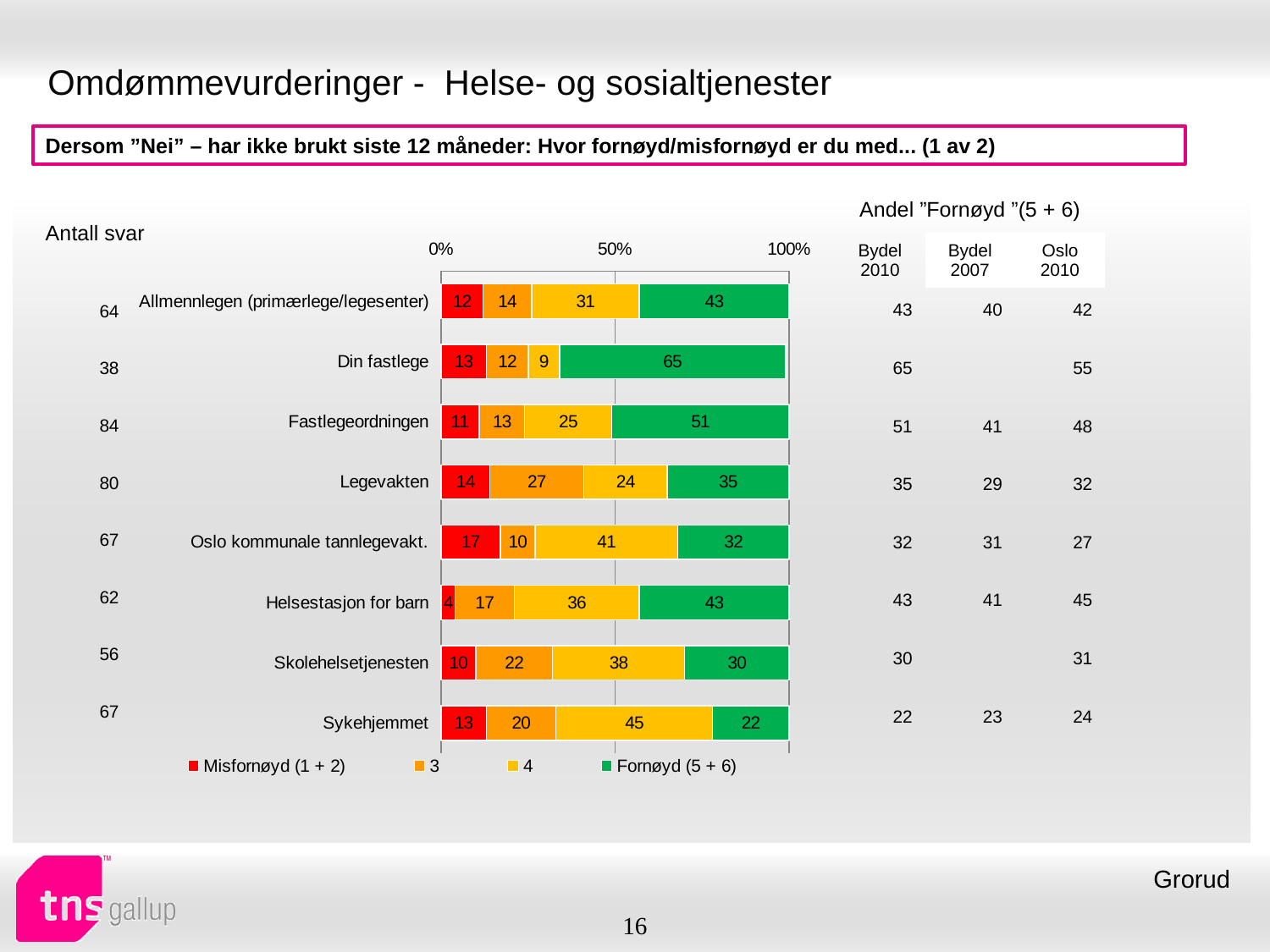
Which has a larger '3' segment value, Legevakten or Skolehelsetjenesten? Legevakten What is the value of the '4' segment for Sykehjemmet? 45 What colour represents the Fornøyd (5 + 6) series in the chart? Green What is the Misfornøyd (1 + 2) value for Oslo kommunale tannlegevakt.? 17 Which category has the highest Fornøyd (5 + 6) value? Din fastlege Which category has the lowest Fornøyd (5 + 6) value? Sykehjemmet What is the difference between the Fornøyd (5 + 6) values for Fastlegeordningen and Legevakten? 16 What is the total of the stacked bar for Allmennlegen (primærlege/legesenter)? 100 How many series does the chart legend list? 4 What kind of chart is shown on the slide? Stacked bar chart What is the Fornøyd (5 + 6) value for Din fastlege? 65 How many categories (services) are plotted in the chart? 8